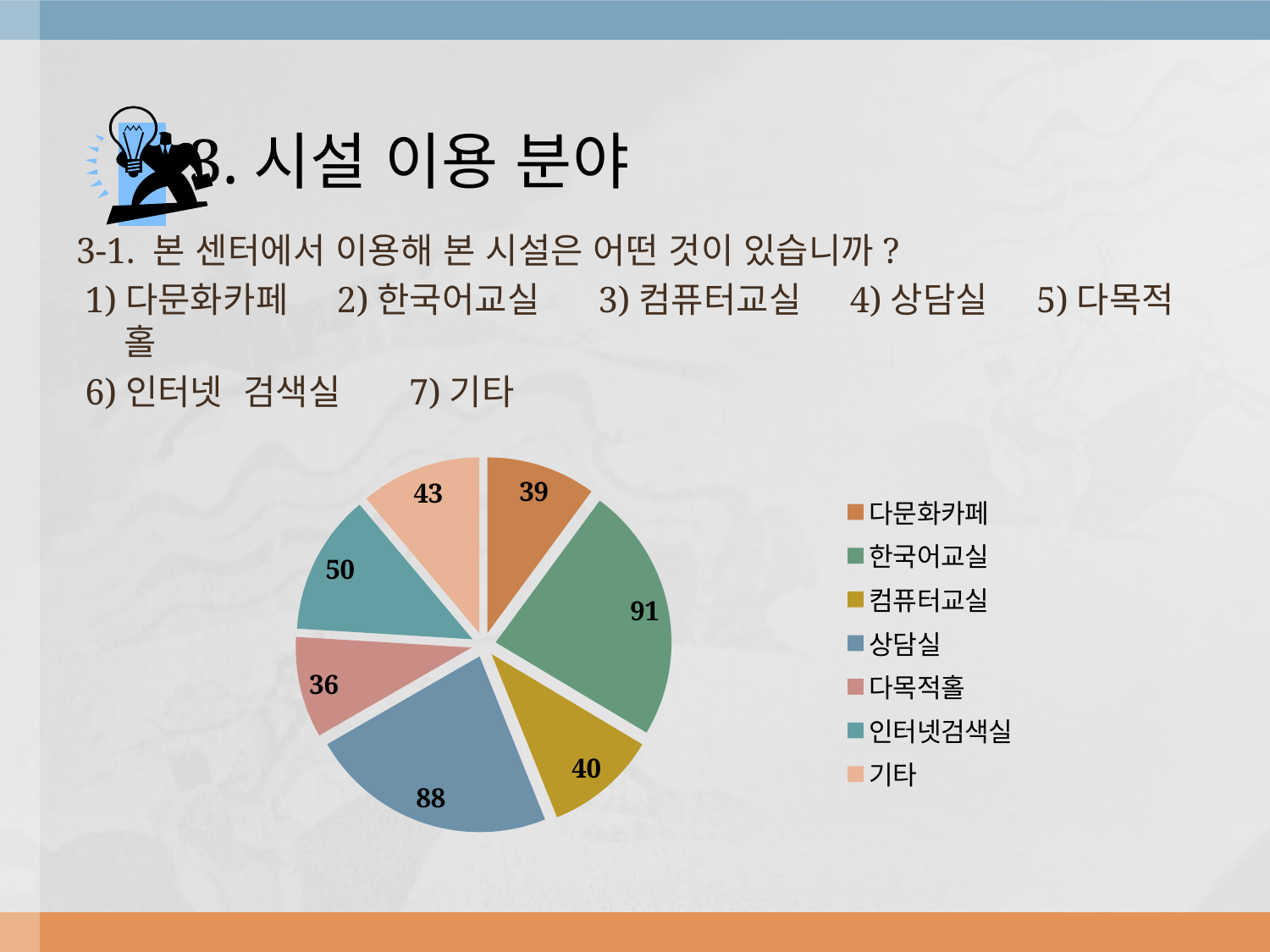
What is the value for 인터넷검색실 in the pie chart? 50 What is the value for 다목적홀 in the pie chart? 36 What is the total of all the values shown in the pie chart? 387 What is the difference between the values for 인터넷검색실 and 다문화카페? 11 Which category has the largest slice in the pie chart? 한국어교실 What is the difference between the values for 한국어교실 and 상담실? 3 How many categories are shown in the pie chart? 7 Which category has the smallest slice in the pie chart? 다목적홀 What is the value for 한국어교실 in the pie chart? 91 What kind of chart is shown on the slide? Pie chart Which is larger, the value for 기타 or the value for 컴퓨터교실? 기타 What is the value for 상담실 in the pie chart? 88